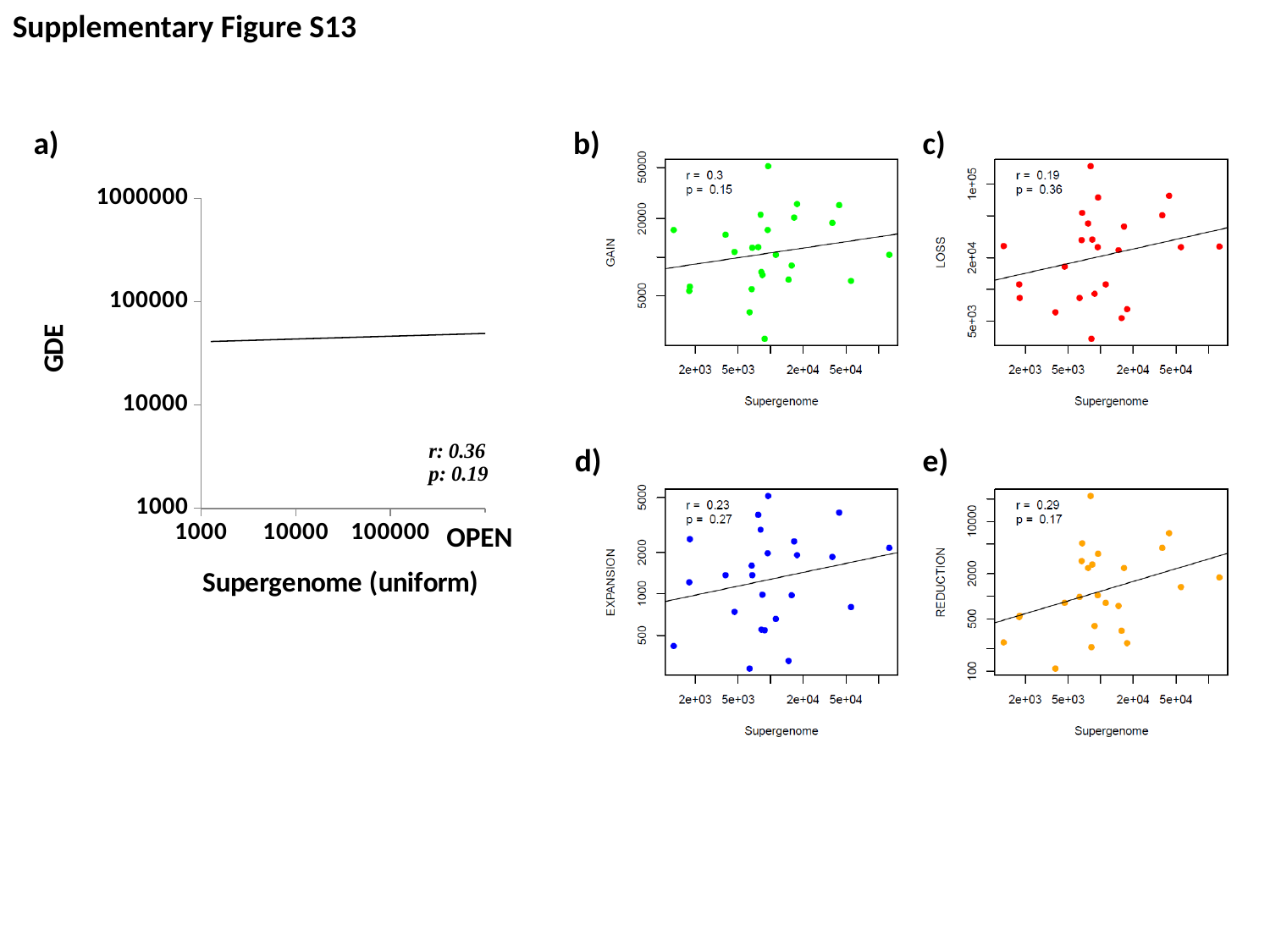
In panel e) (REDUCTION), does the fitted line rise or fall as Supergenome increases? rise In panel d) (EXPANSION), what is the printed r value? 0.23 Which panel has the lowest printed r value: b), c), d) or e)? c) In panel a), what is the x-axis label? Supergenome (uniform) In panel a), what is the printed p value? 0.19 What kind of chart is panel b) (GAIN)? scatter plot In panel a), what is the y-axis label? GDE Is the printed r value in panel b) (GAIN) larger or smaller than the r value in panel c) (LOSS)? larger In panel c) (LOSS), what is the printed p value? 0.36 In panel a), what is the printed r value? 0.36 In panel b) (GAIN), what is the printed r value? 0.3 In panel e) (REDUCTION), what is the printed p value? 0.17